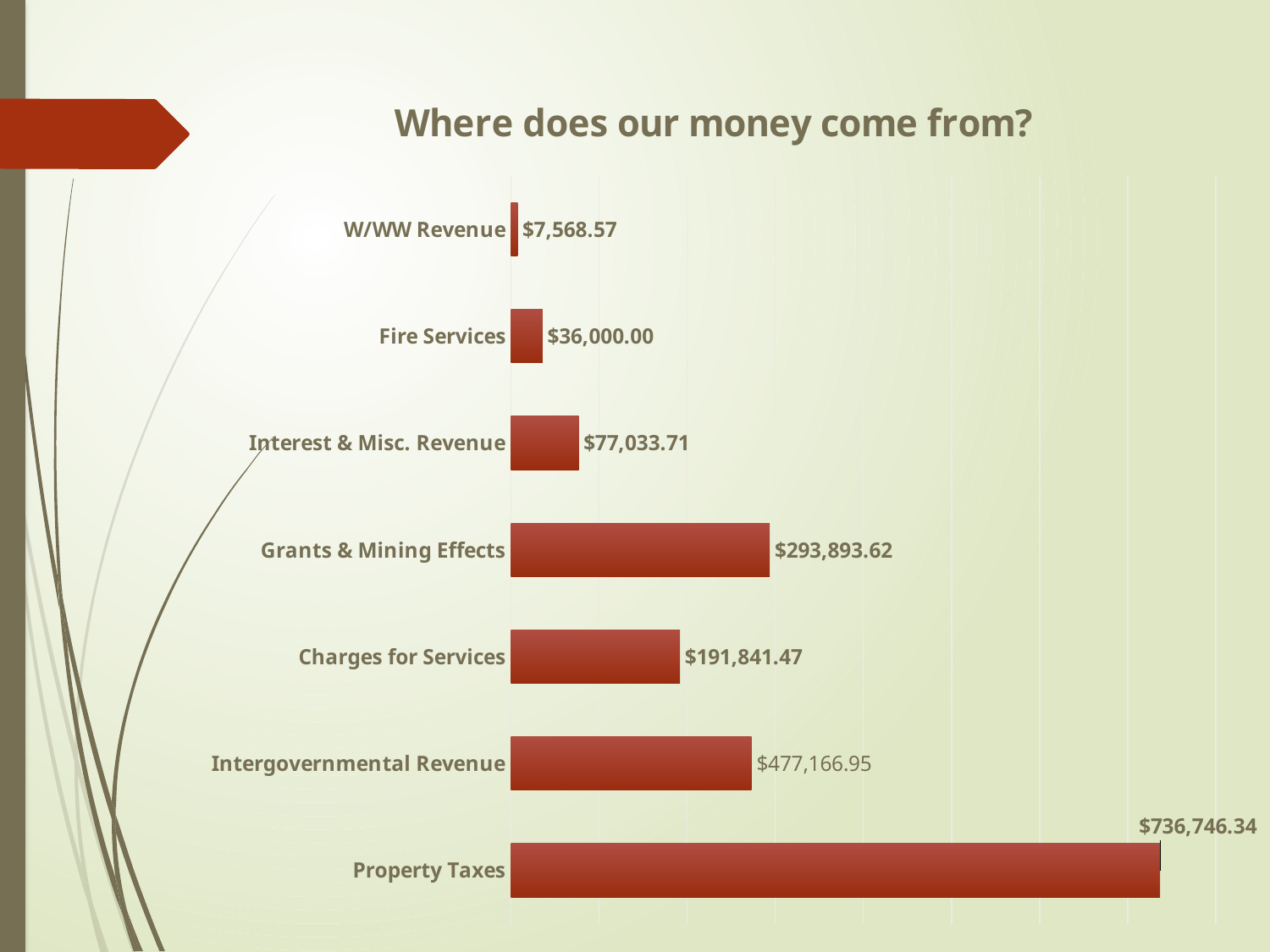
Which is larger, Charges for Services or Interest & Misc. Revenue? Charges for Services What is the value for Fire Services? $36,000.00 What is the difference between Property Taxes and Intergovernmental Revenue? $259,579.39 Which category has the lowest value? W/WW Revenue How many categories are shown in the chart? 7 What is the title of the slide? Where does our money come from? What is the value for Grants & Mining Effects? $293,893.62 What kind of chart is shown on the slide? Bar chart Which category has the highest value? Property Taxes What is the value for Property Taxes? $736,746.34 What is the value for Intergovernmental Revenue? $477,166.95 What is the difference between Grants & Mining Effects and Charges for Services? $102,052.15